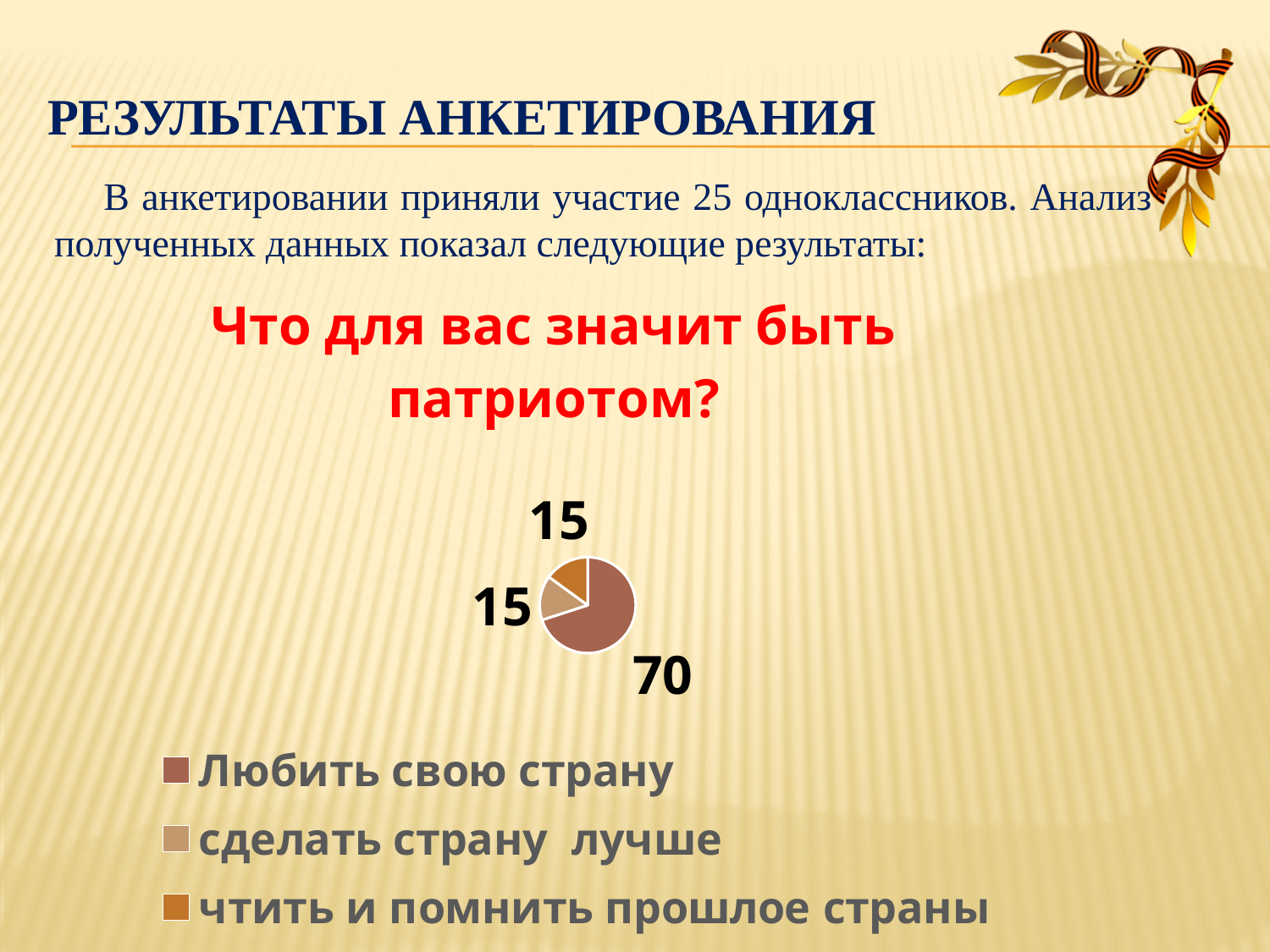
What is the value for "Любить свою страну"? 70 What is the difference between the values for "Любить свою страну" and "сделать страну лучше"? 55 What is the value for "сделать страну лучше"? 15 What is the title of the chart? Что для вас значит быть патриотом? What is the value for "чтить и помнить прошлое страны"? 15 How many categories does the pie chart have? 3 Which is larger: the value for "Любить свою страну" or the value for "чтить и помнить прошлое страны"? Любить свою страну What kind of chart is shown on the slide? pie chart What share of the pie does "Любить свою страну" take? 70% How many entries does the legend list? 3 Which category has the largest slice of the pie? Любить свою страну What is the total of all the values in the pie chart? 100